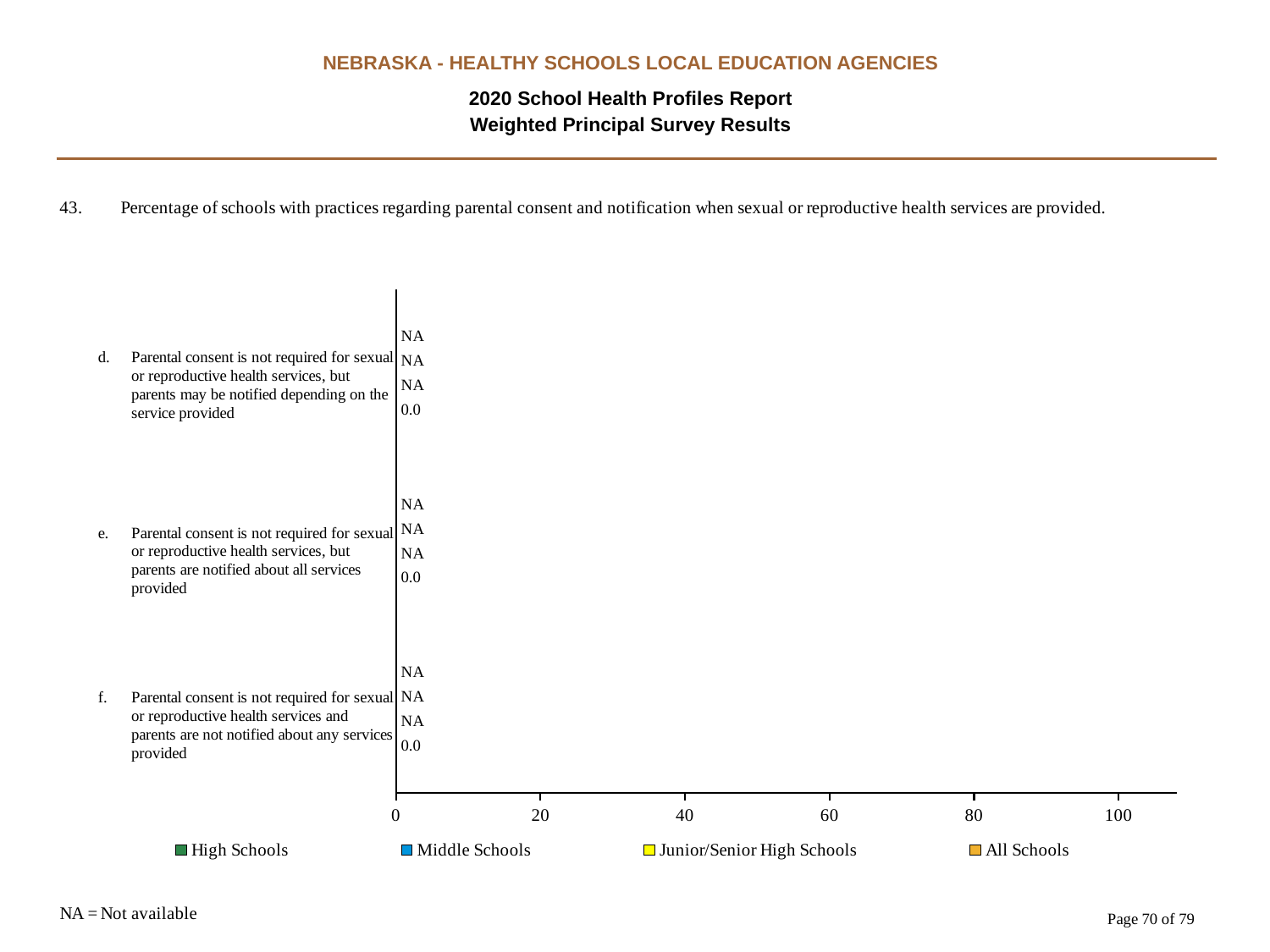
What is the value for All Schools for item f (parental consent not required and parents are not notified about any services provided)? 0.0 Which series is listed last in the legend? All Schools What is the value for All Schools for item d (parental consent not required, but parents may be notified depending on the service provided)? 0.0 According to the note at the bottom of the slide, what does NA stand for? Not available How many categories (lettered items) are plotted on the chart? 3 What is shown for High Schools for item d? NA What is shown for Middle Schools for item e? NA What kind of chart is shown on the slide? bar chart What is the maximum value shown on the x axis? 100 What is the value for All Schools for item e (parental consent not required, but parents are notified about all services provided)? 0.0 What is shown for Junior/Senior High Schools for item f? NA How many series does the legend list? 4